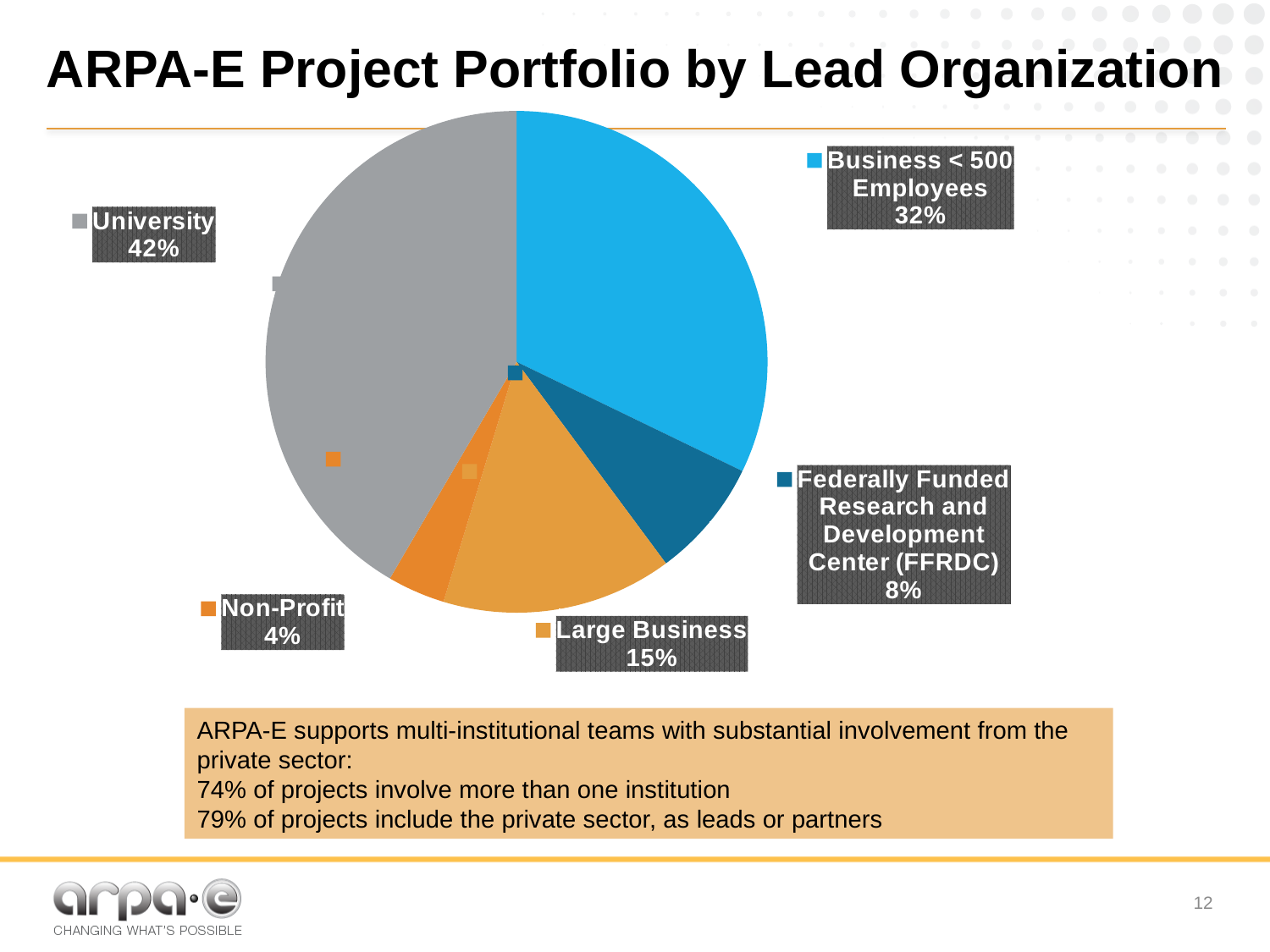
Which has a larger share: Business < 500 Employees or Large Business? Business < 500 Employees What is the title of the slide containing the chart? ARPA-E Project Portfolio by Lead Organization How many percentage points larger is the University share than the Large Business share? 27 Which lead organization type has the largest share of the portfolio? University What share of the ARPA-E project portfolio is led by universities? 42% What percentage of projects are led by businesses with fewer than 500 employees? 32% How many lead organization categories are shown in the pie chart? 5 What share of the portfolio is led by Large Business? 15% What share of projects are led by Non-Profit organizations? 4% What percentage of projects are led by a Federally Funded Research and Development Center (FFRDC)? 8% Which lead organization type has the smallest share of the portfolio? Non-Profit What type of chart is shown on the slide? Pie chart